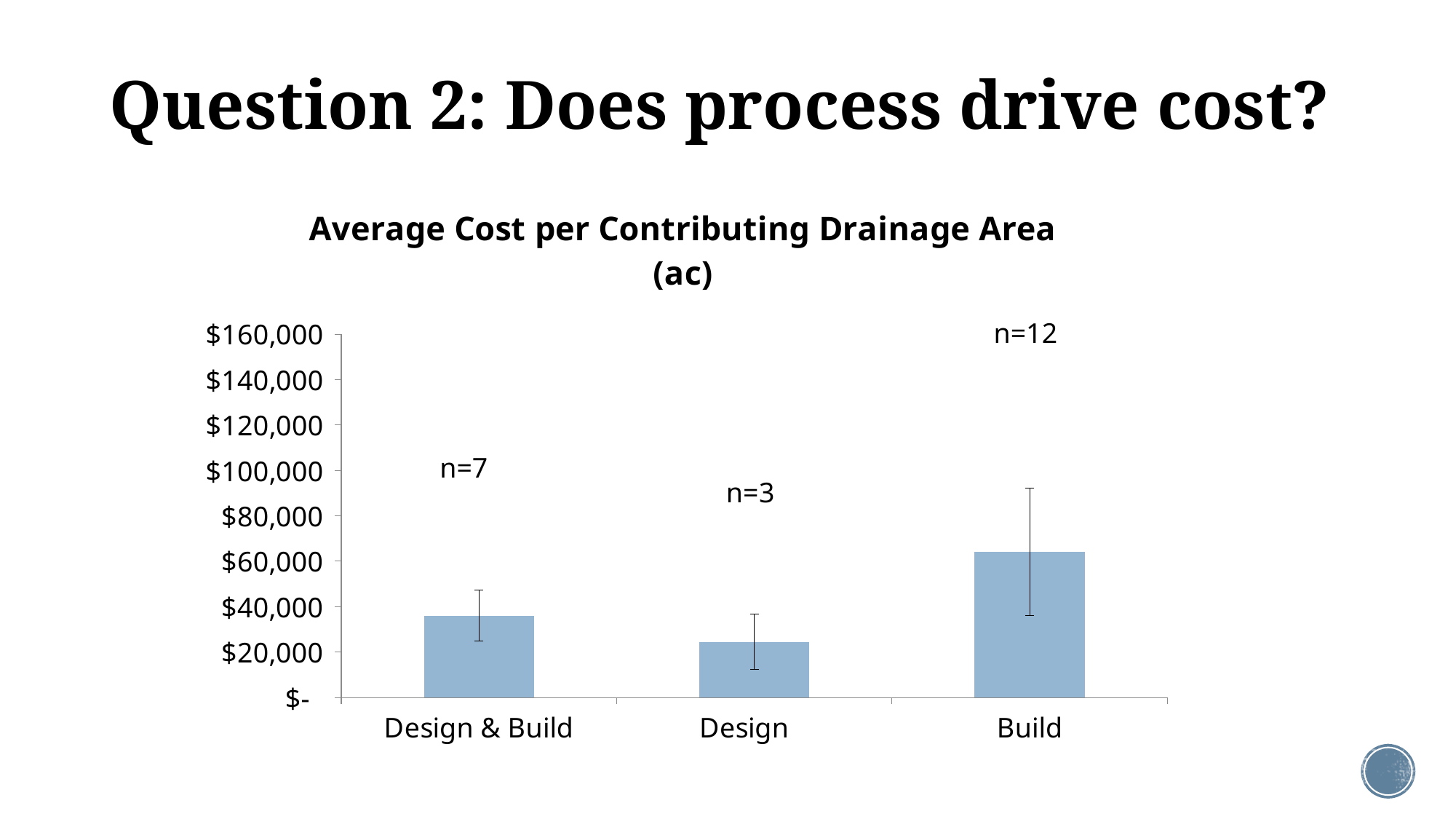
Which has a higher average cost, Build or Design & Build? Build How many categories are shown on the x axis of the chart? 3 Is the value for Design greater or less than $20,000? greater What kind of chart is shown on the slide? bar chart Is the value for Design & Build greater or less than $40,000? less What sample size is printed above the Build bar? n=12 What is the title of the chart? Average Cost per Contributing Drainage Area (ac) Is the value for Build greater or less than $60,000? greater What sample size is printed above the Design bar? n=3 Which has a higher average cost, Design & Build or Design? Design & Build Which category has the highest average cost per contributing drainage area? Build Which category has the lowest average cost per contributing drainage area? Design